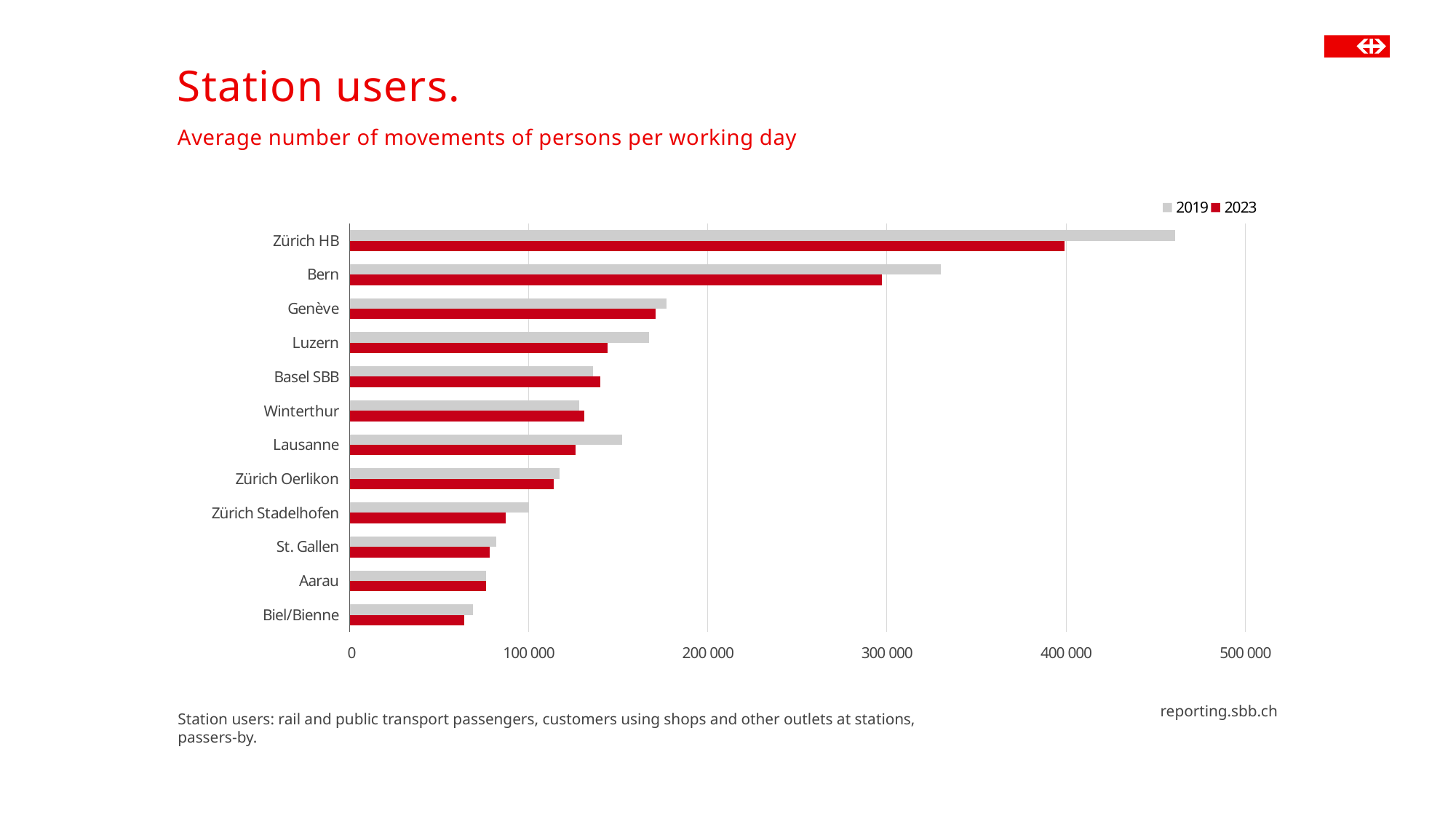
How many stations are shown on the chart? 12 For Lausanne, which year has the larger value, 2019 or 2023? 2019 How many series does the legend list? 2 Which has the larger 2019 value, Zürich HB or Bern? Zürich HB Is the 2019 value for Zürich HB greater or less than 400 000? greater Is the 2023 value for Zürich Stadelhofen greater or less than 100 000? less Is the 2019 value for Genève greater or less than 200 000? less Which station has the lowest number of station users in 2019? Biel/Bienne Which station has the highest number of station users in 2023? Zürich HB Which colour represents the 2023 series in the legend? red What kind of chart is shown on the slide? bar chart